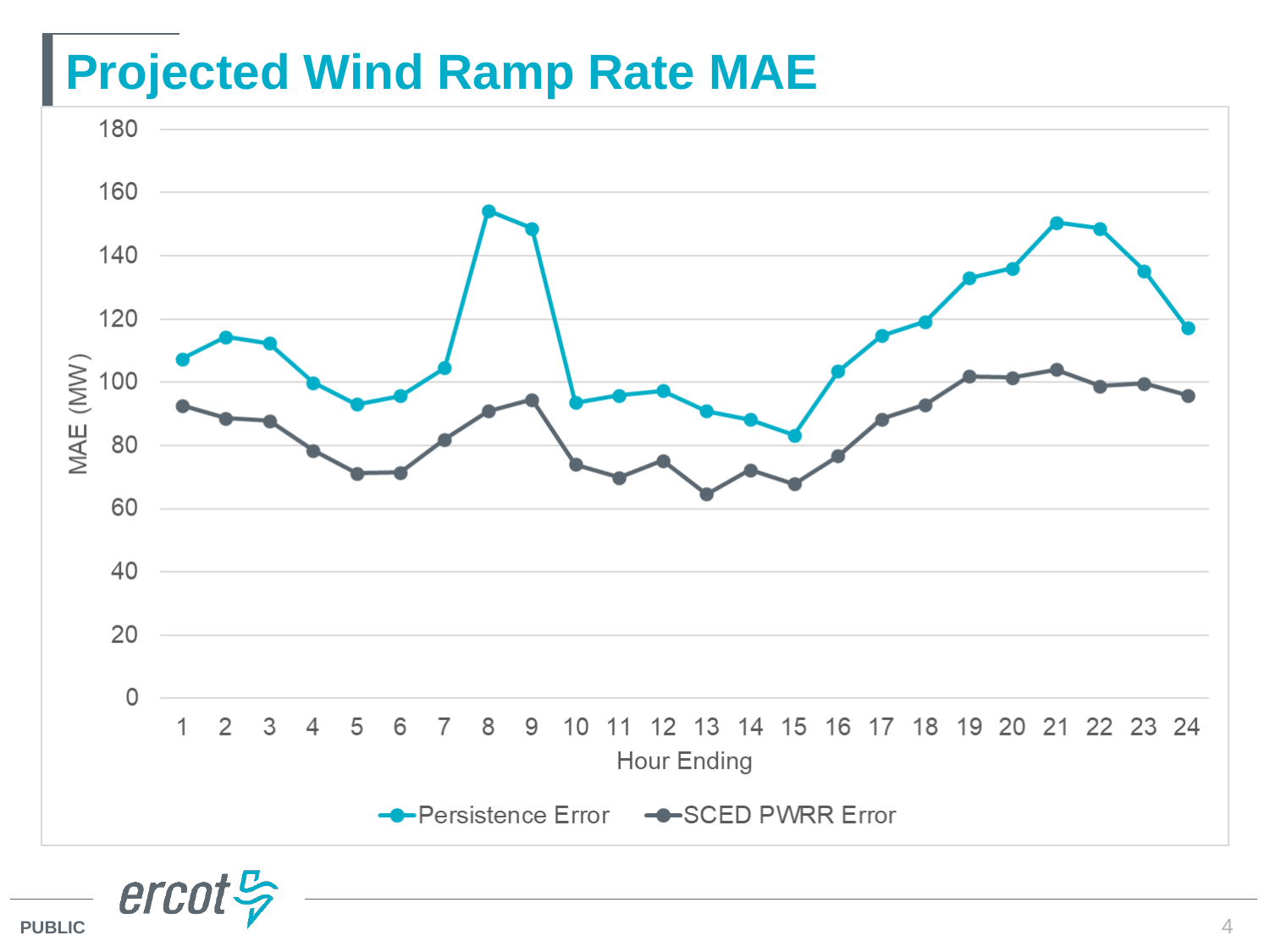
Is the Persistence Error at hour ending 15 greater or less than 100? less Is the Persistence Error at hour ending 8 greater or less than 140? greater What kind of chart is shown on the slide? line chart At which hour ending is the SCED PWRR Error lowest? 13 How many series does the legend list? 2 Does the Persistence Error rise or fall from hour ending 15 to hour ending 21? rise How many hours are plotted along the x axis? 24 At which hour ending does the Persistence Error reach its highest value? 8 Is the SCED PWRR Error at hour ending 13 greater or less than 80? less At which hour ending is the Persistence Error lowest? 15 What is the label on the y axis? MAE (MW) At hour ending 8, which series has the larger value, Persistence Error or SCED PWRR Error? Persistence Error